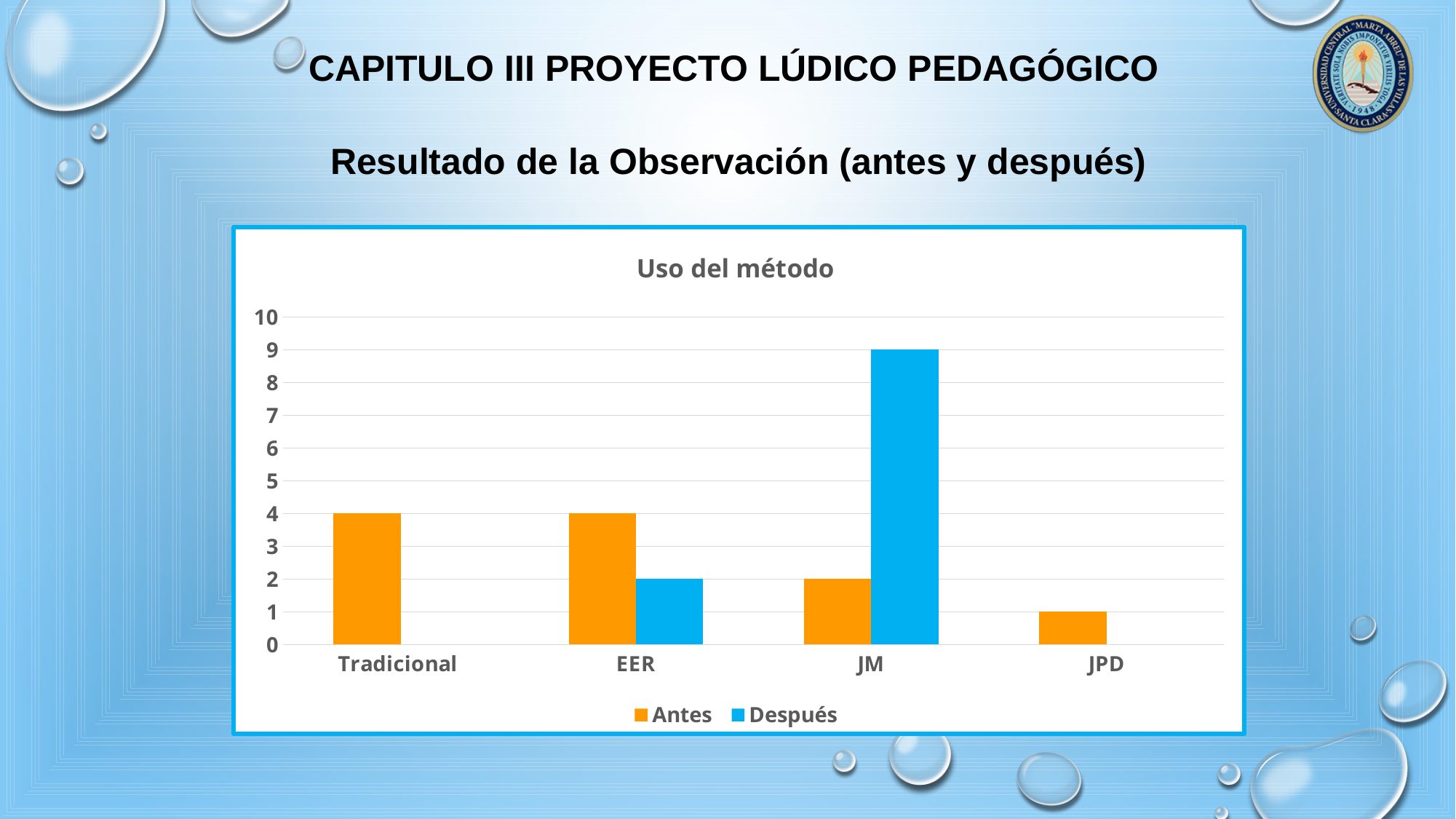
How many categories are shown on the x axis? 4 Which category has the highest Después value? JM What kind of chart is shown on the slide? bar chart What is the difference between the Después and Antes values for JM? 7 What is the Después value for EER? 2 What is the title of the chart? Uso del método Which category has the lowest Antes value? JPD What is the Después value for JM? 9 What is the Antes value for Tradicional? 4 How many series does the legend list? 2 For EER, which is larger, the Antes value or the Después value? Antes What is the Antes value for JPD? 1